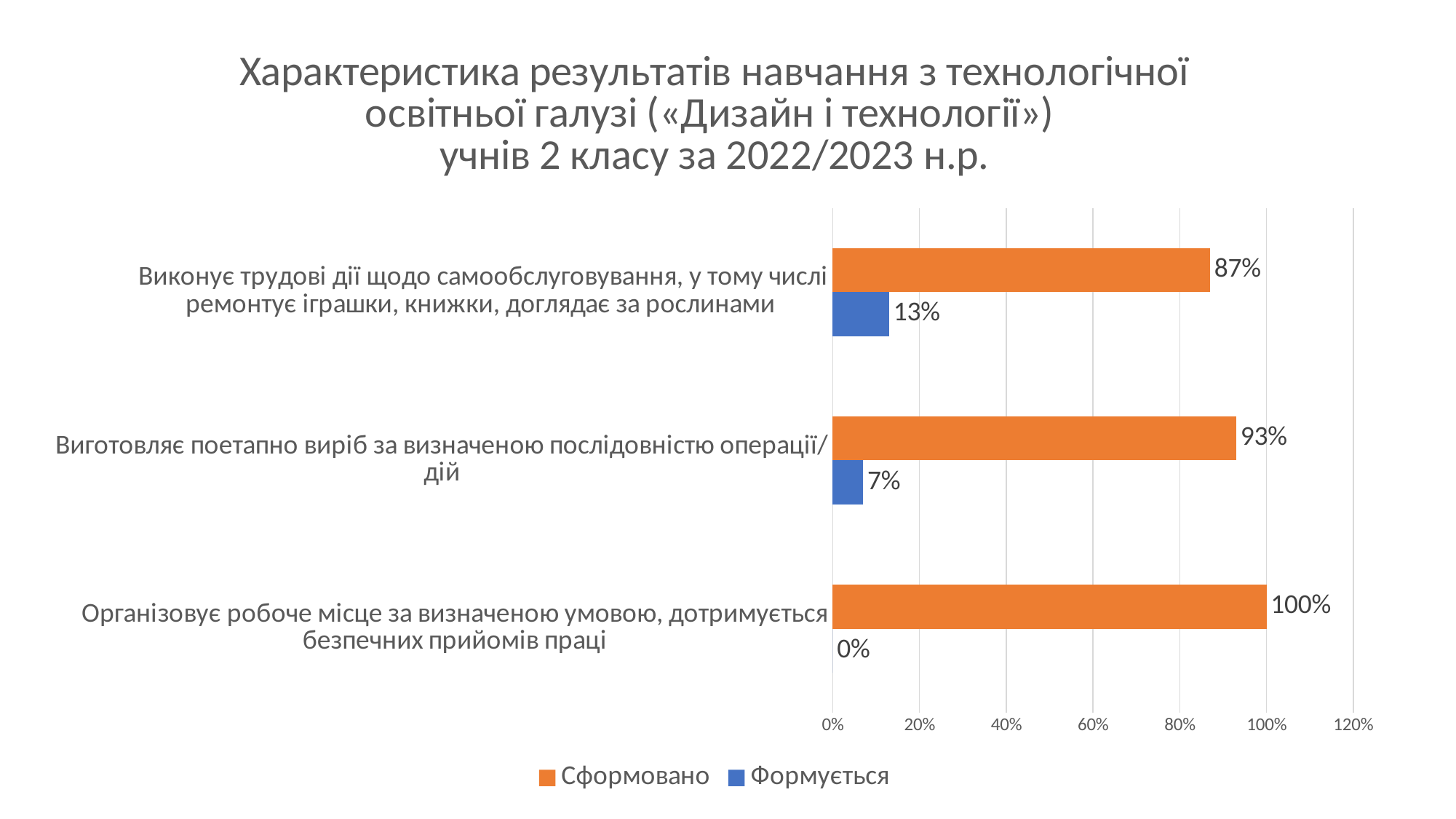
What kind of chart is shown on the slide? bar chart Which category has the lowest "Сформовано" value? Виконує трудові дії щодо самообслуговування, у тому числі ремонтує іграшки, книжки, доглядає за рослинами What is the "Формується" value for "Виготовляє поетапно виріб за визначеною послідовністю операції/дій"? 7% What is the "Сформовано" value for "Виконує трудові дії щодо самообслуговування, у тому числі ремонтує іграшки, книжки, доглядає за рослинами"? 87% Which colour represents the "Формується" series? blue Which is larger: the "Формується" value for "Виконує трудові дії щодо самообслуговування..." or for "Виготовляє поетапно виріб..."? Виконує трудові дії щодо самообслуговування, у тому числі ремонтує іграшки, книжки, доглядає за рослинами What is the difference between the "Сформовано" and "Формується" values for "Виготовляє поетапно виріб за визначеною послідовністю операції/дій"? 86% Is the "Сформовано" value for "Виготовляє поетапно виріб за визначеною послідовністю операції/дій" greater or less than 80%? greater How many categories are shown on the chart? 3 How many series does the legend list? 2 What is the "Формується" value for "Організовує робоче місце за визначеною умовою, дотримується безпечних прийомів праці"? 0% Which category has the highest "Сформовано" value? Організовує робоче місце за визначеною умовою, дотримується безпечних прийомів праці